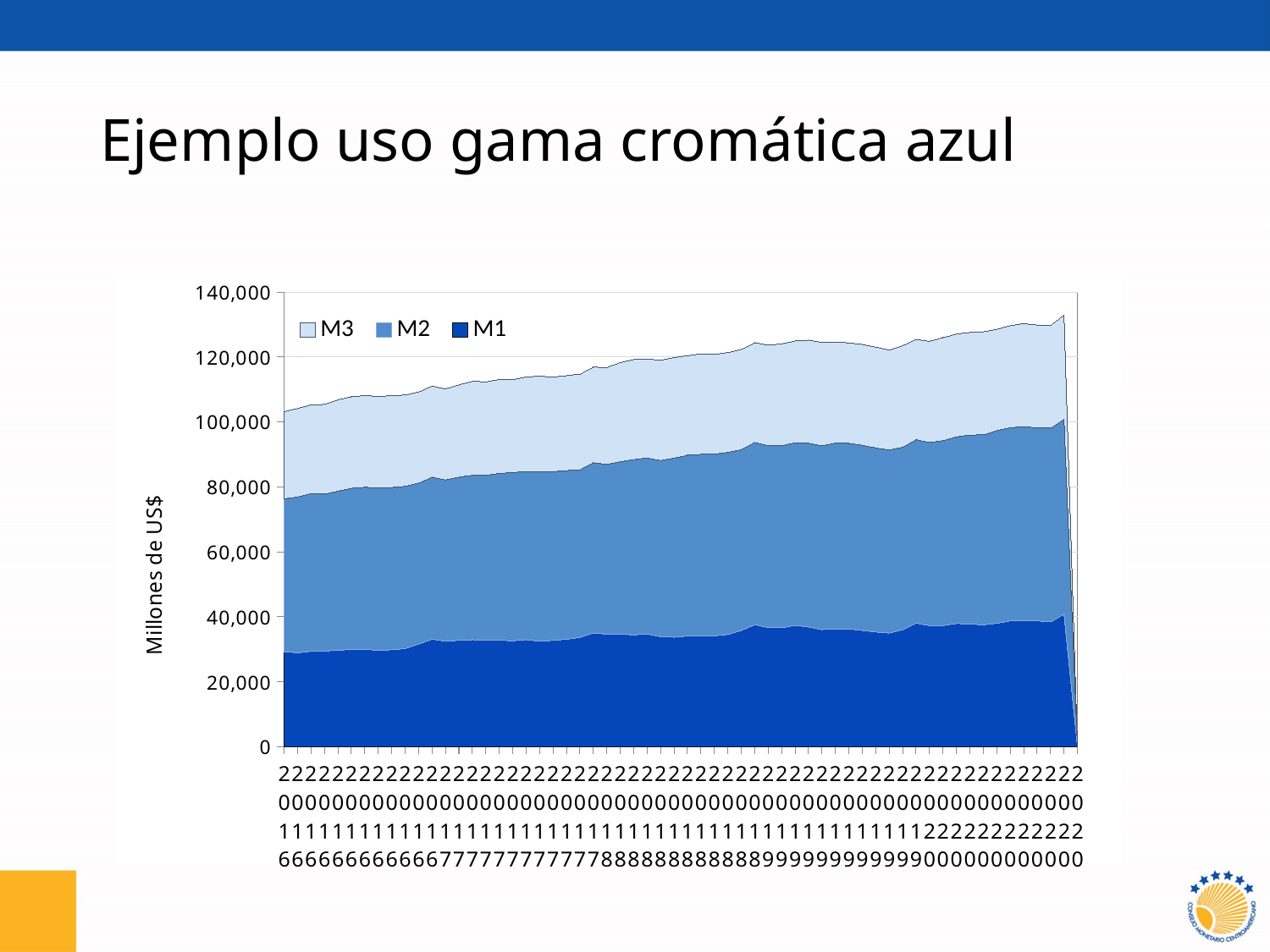
What is the title of the vertical axis of the chart? Millones de US$ What kind of chart is shown on the slide? Stacked area chart Which year appears first on the horizontal axis of the chart? 2016 Is the total of the stacked areas at the start of 2016 greater or less than 100,000? greater Is the value of M1 at the start of 2016 greater or less than 40,000? less Does the total height of the stacked areas generally rise or fall from 2016 to 2020? Rise Is the total of the stacked areas near the end of 2020 (before the final drop) greater or less than 120,000? greater What are the series names listed in the chart's legend? M3, M2, M1 What is the highest value shown on the vertical axis of the chart? 140,000 How many series does the chart's legend list? 3